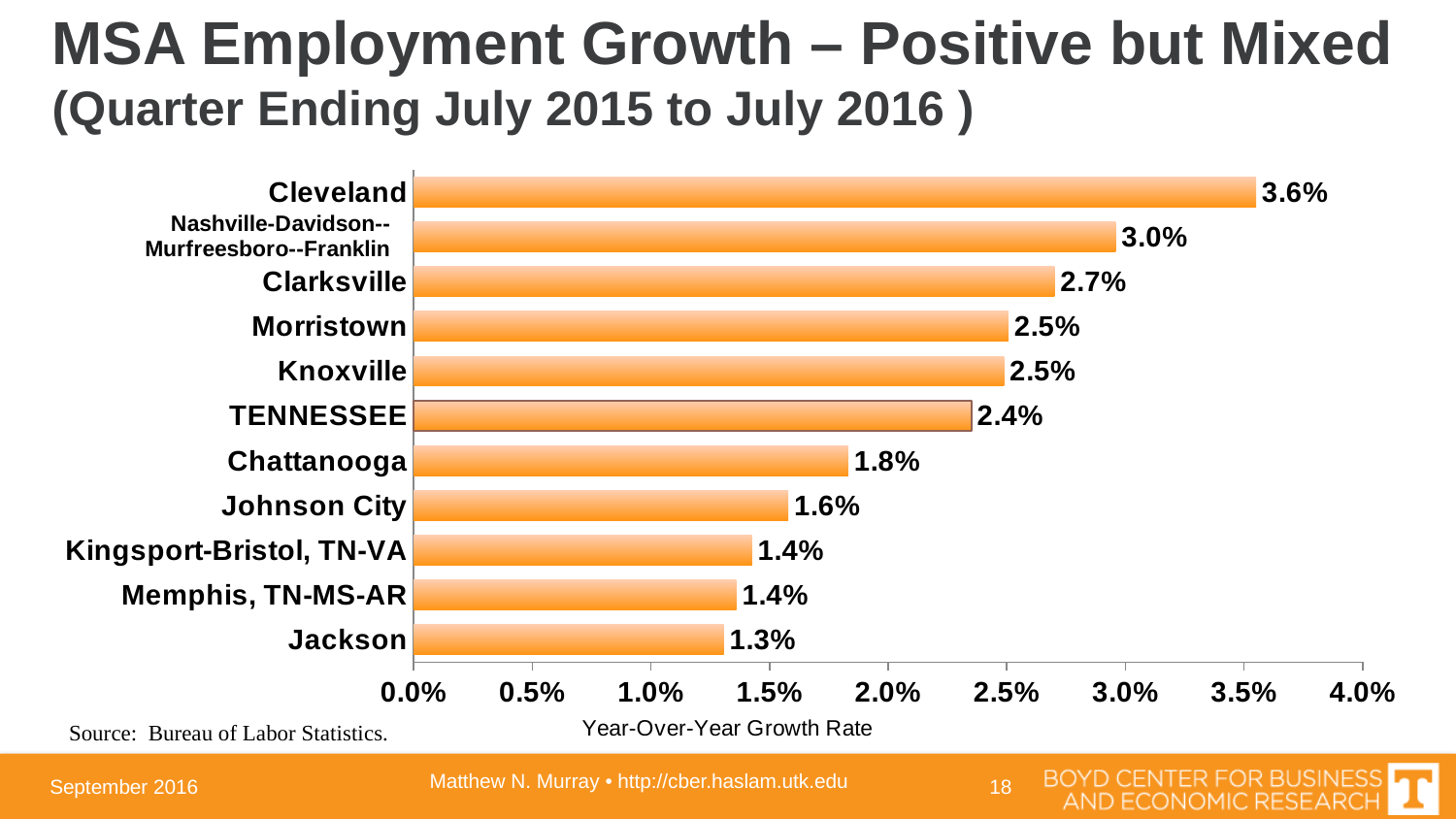
What is the employment growth rate shown for Jackson? 1.3% What kind of chart is shown on the slide? Bar chart Which MSA has the highest employment growth rate? Cleveland Which has a higher employment growth rate, Chattanooga or Johnson City? Chattanooga What is the label of the horizontal axis? Year-Over-Year Growth Rate What is the year-over-year employment growth rate for Cleveland? 3.6% What is the employment growth rate shown for TENNESSEE? 2.4% How many categories (bars) are shown in the chart? 11 Which MSA has the lowest employment growth rate? Jackson What is the difference between the growth rates of Cleveland and Nashville-Davidson--Murfreesboro--Franklin? 0.6% Is the value for Morristown greater or less than 2.0%? greater What is the employment growth rate shown for Clarksville? 2.7%